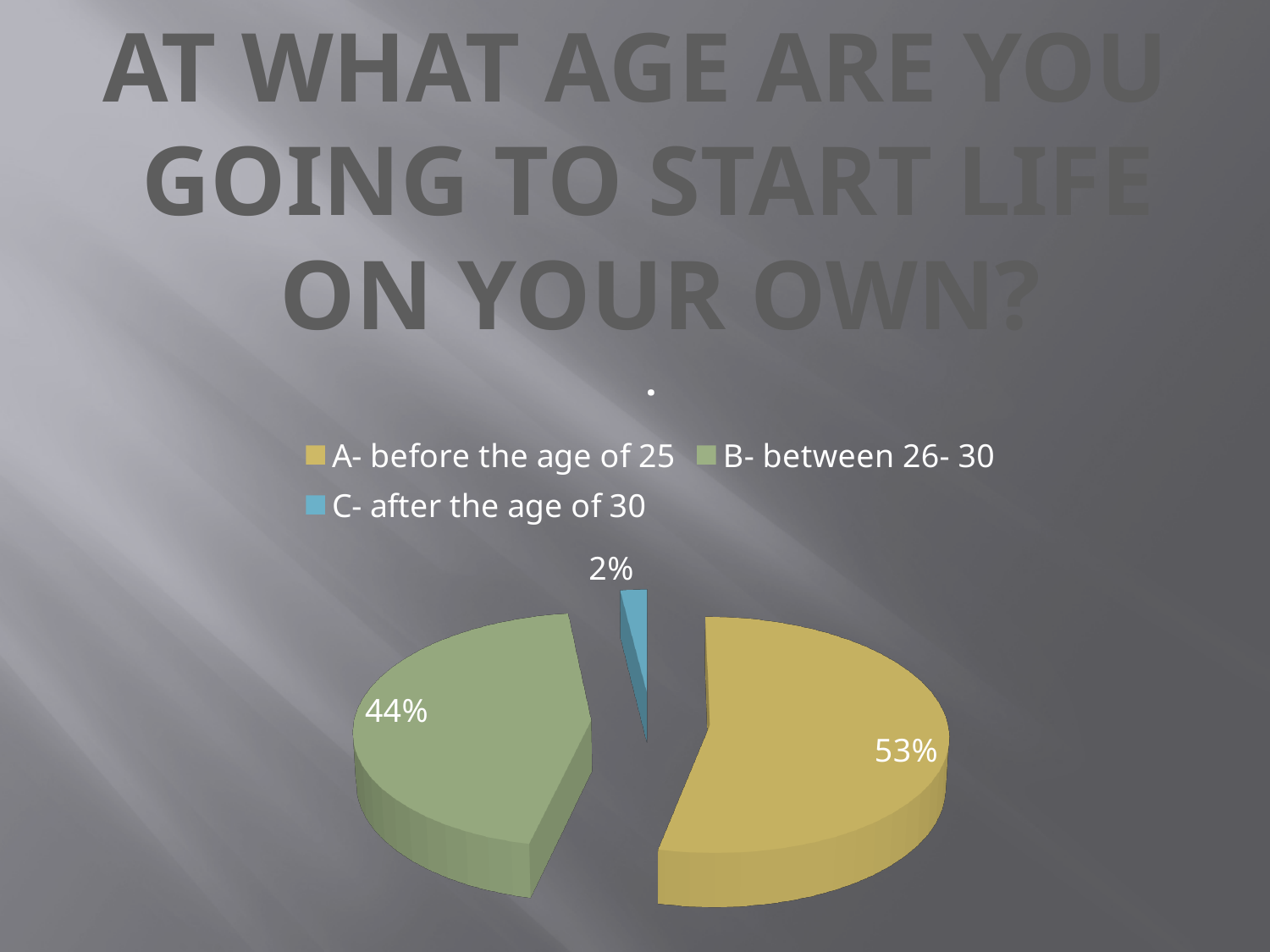
Which is larger, the share for 'B- between 26- 30' or the share for 'C- after the age of 30'? B- between 26- 30 What is the difference in percentage points between 'B- between 26- 30' and 'C- after the age of 30'? 42 How many entries does the legend list? 3 How many slices does the pie chart have? 3 What colour is the slice for 'C- after the age of 30'? blue What percentage of the pie is for 'B- between 26- 30'? 44% What is the difference in percentage points between 'A- before the age of 25' and 'B- between 26- 30'? 9 Which category has the smallest share of the pie? C- after the age of 30 What percentage of the pie is for 'A- before the age of 25'? 53% Which category has the largest share of the pie? A- before the age of 25 What kind of chart is shown on the slide? pie chart What percentage of the pie is for 'C- after the age of 30'? 2%